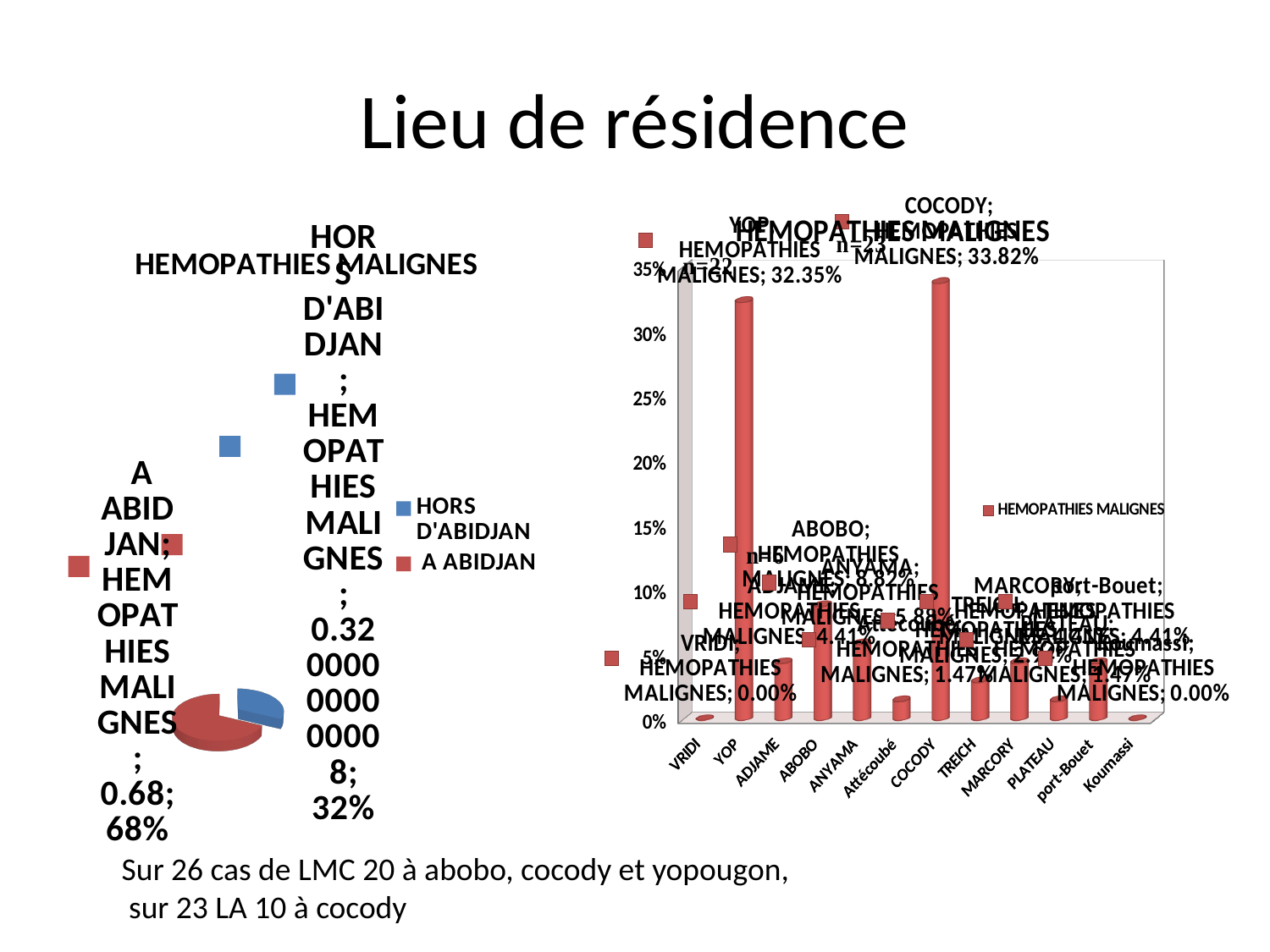
On the bar chart on the right, what is the difference between the values for COCODY and YOP? 1.47 percentage points On the bar chart on the right, how many categories are shown on the x axis? 12 What kind of chart is the chart on the right? Bar chart On the bar chart on the right, is the value for ABOBO greater or less than 10%? less On the pie chart on the left, what share of the pie is A ABIDJAN? 68% On the bar chart on the right, what is the value for COCODY? 33.82% On the bar chart on the right, what is the value for YOP? 32.35% On the pie chart on the left, how many slices does the pie have? 2 On the pie chart on the left, which slice is larger, A ABIDJAN or HORS D'ABIDJAN? A ABIDJAN On the bar chart on the right, which category has the highest value? COCODY On the pie chart on the left, what share of the pie is HORS D'ABIDJAN? 32% On the bar chart on the right, what is the value for ABOBO? 8.82%